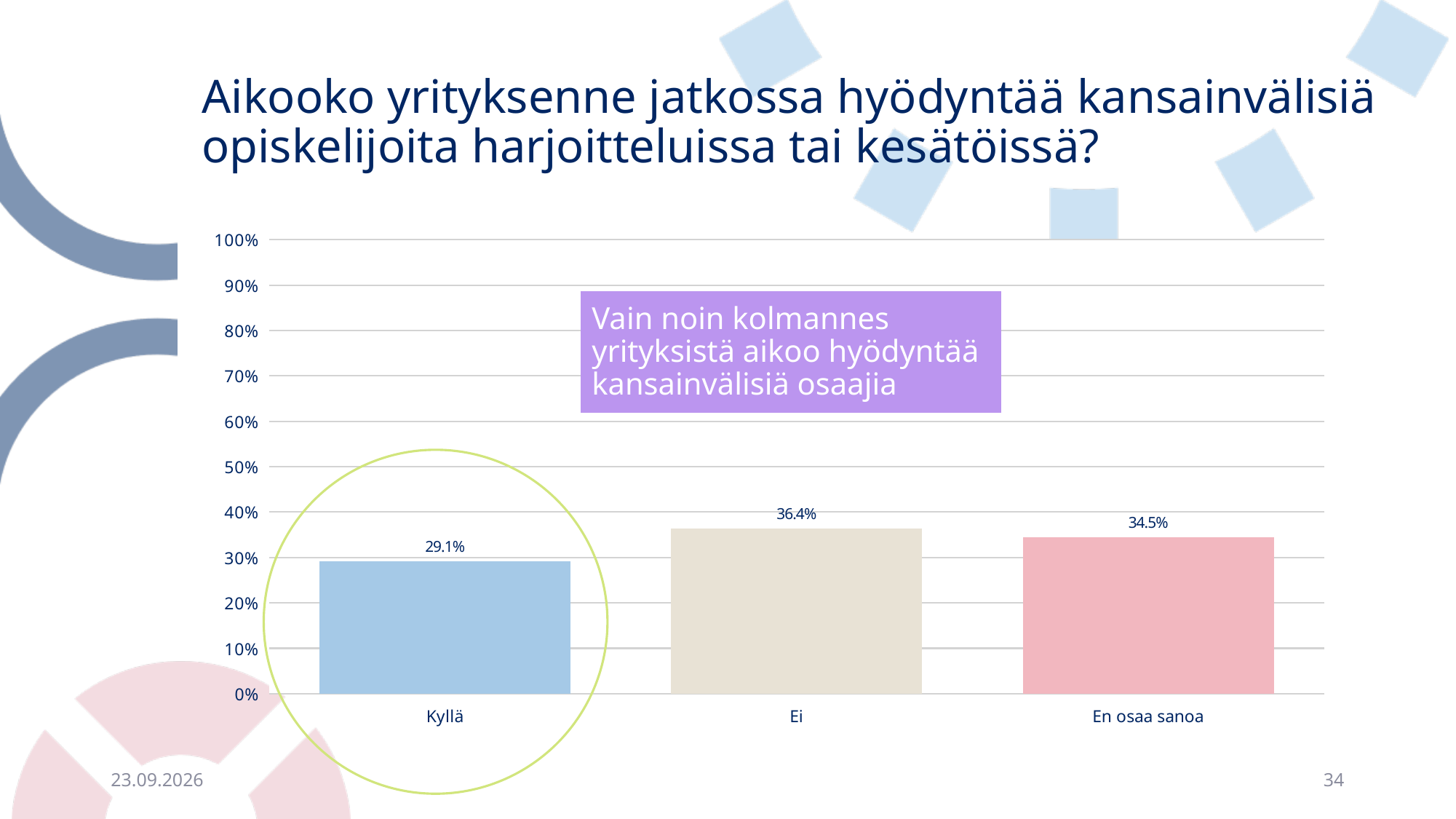
What is the value for Kyllä? 29.1% What is the value for En osaa sanoa? 34.5% What is the difference between the values for Ei and En osaa sanoa? 1.9% What is the value for Ei? 36.4% Which category has the lowest value? Kyllä How many categories are shown on the x axis? 3 Which is larger, the value for Kyllä or the value for En osaa sanoa? En osaa sanoa Which category has the highest value? Ei What is the highest value shown on the y axis? 100% What is the difference between the values for Ei and Kyllä? 7.3% What kind of chart is shown on the slide? bar chart Is the value for Kyllä greater or less than 30%? less